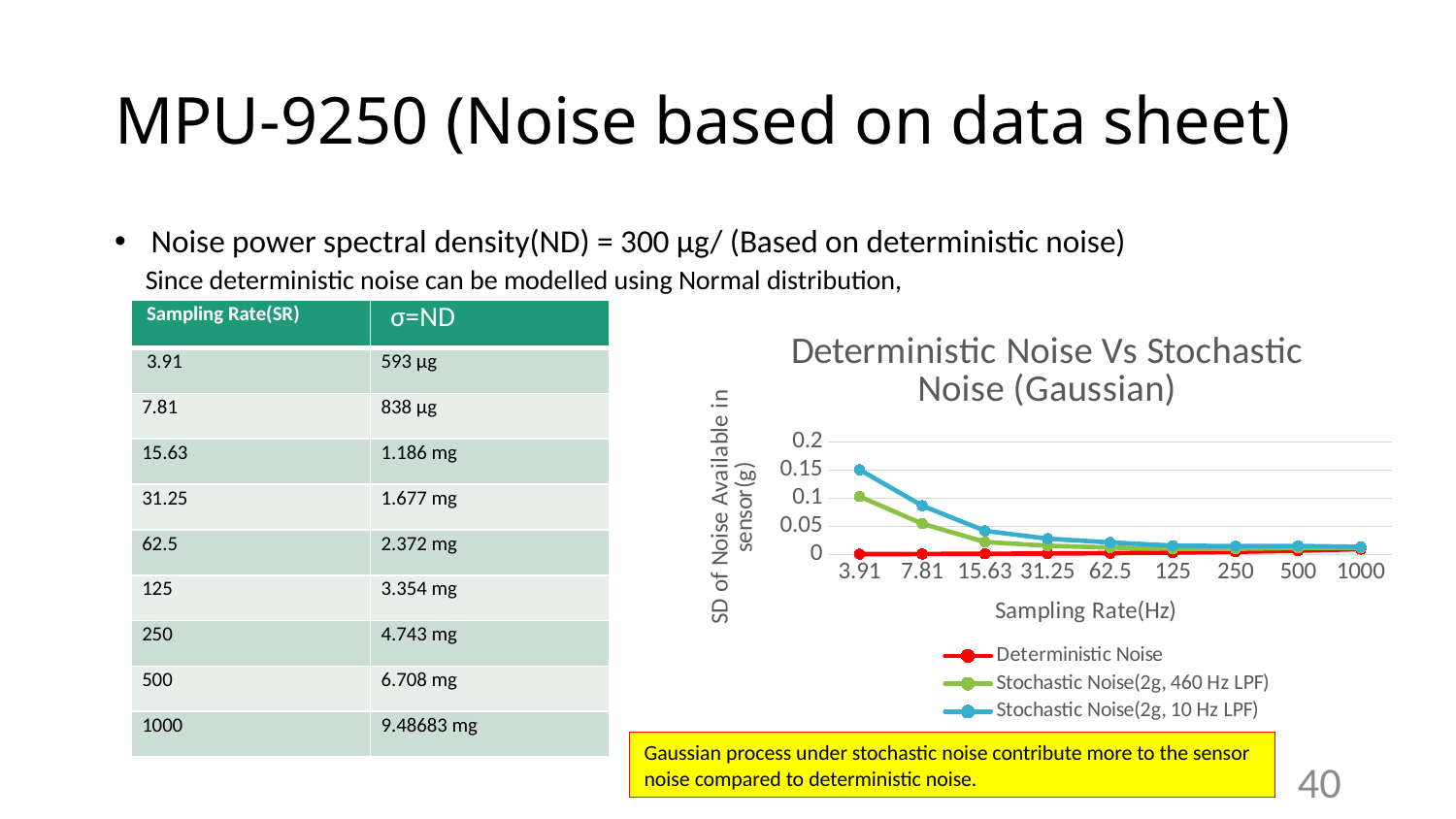
At which sampling rate is the Stochastic Noise(2g, 10 Hz LPF) series highest? 3.91 What is the title of the chart? Deterministic Noise Vs Stochastic Noise (Gaussian) How many series does the chart legend list? 3 Is the value for Deterministic Noise at sampling rate 3.91 greater or less than 0.05? less How many sampling rate values are plotted along the x axis of the chart? 9 What kind of chart is shown on the slide? line chart What is the label of the x axis of the chart? Sampling Rate(Hz) Is the value for Stochastic Noise(2g, 10 Hz LPF) at sampling rate 7.81 greater or less than 0.1? less Do the values of the Stochastic Noise(2g, 10 Hz LPF) series rise or fall as the sampling rate increases along the x axis? fall Is the value for Stochastic Noise(2g, 10 Hz LPF) at sampling rate 3.91 greater or less than 0.1? greater